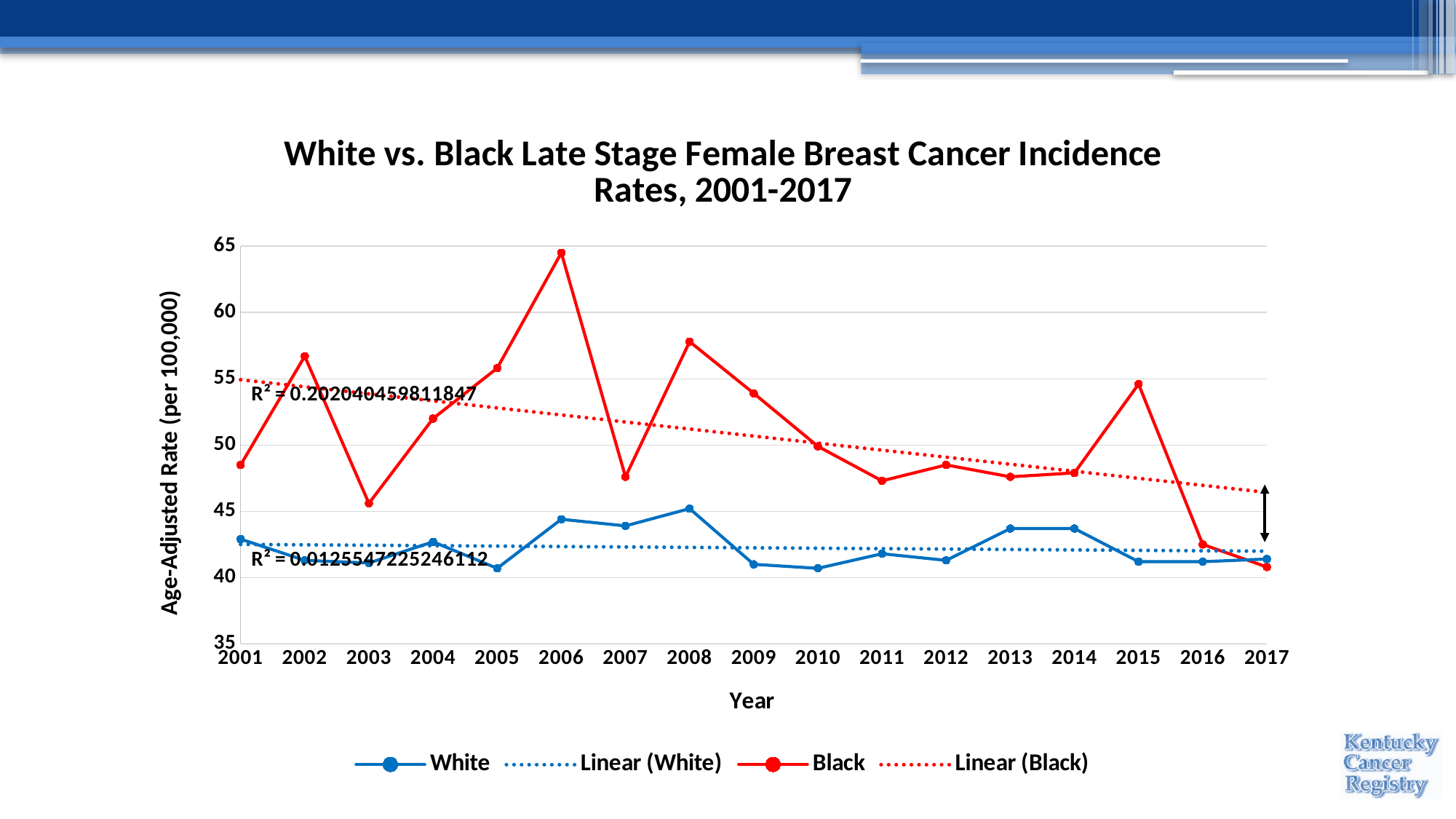
In which year does the White series reach its highest value? 2008 What is the label on the y axis? Age-Adjusted Rate (per 100,000) Is the value for Black in 2008 greater or less than 55? greater Which series has the larger value in 2006, White or Black? Black In which year does the Black series reach its highest value? 2006 How many years are plotted along the x axis? 17 Is the value for Black in 2006 greater or less than 60? greater What kind of chart is shown on the slide? line chart Is the value for Black in 2003 greater or less than 50? less How many entries does the legend list? 4 In which year does the Black series reach its lowest value? 2017 Does the dotted Linear (Black) trend line rise or fall from 2001 to 2017? fall